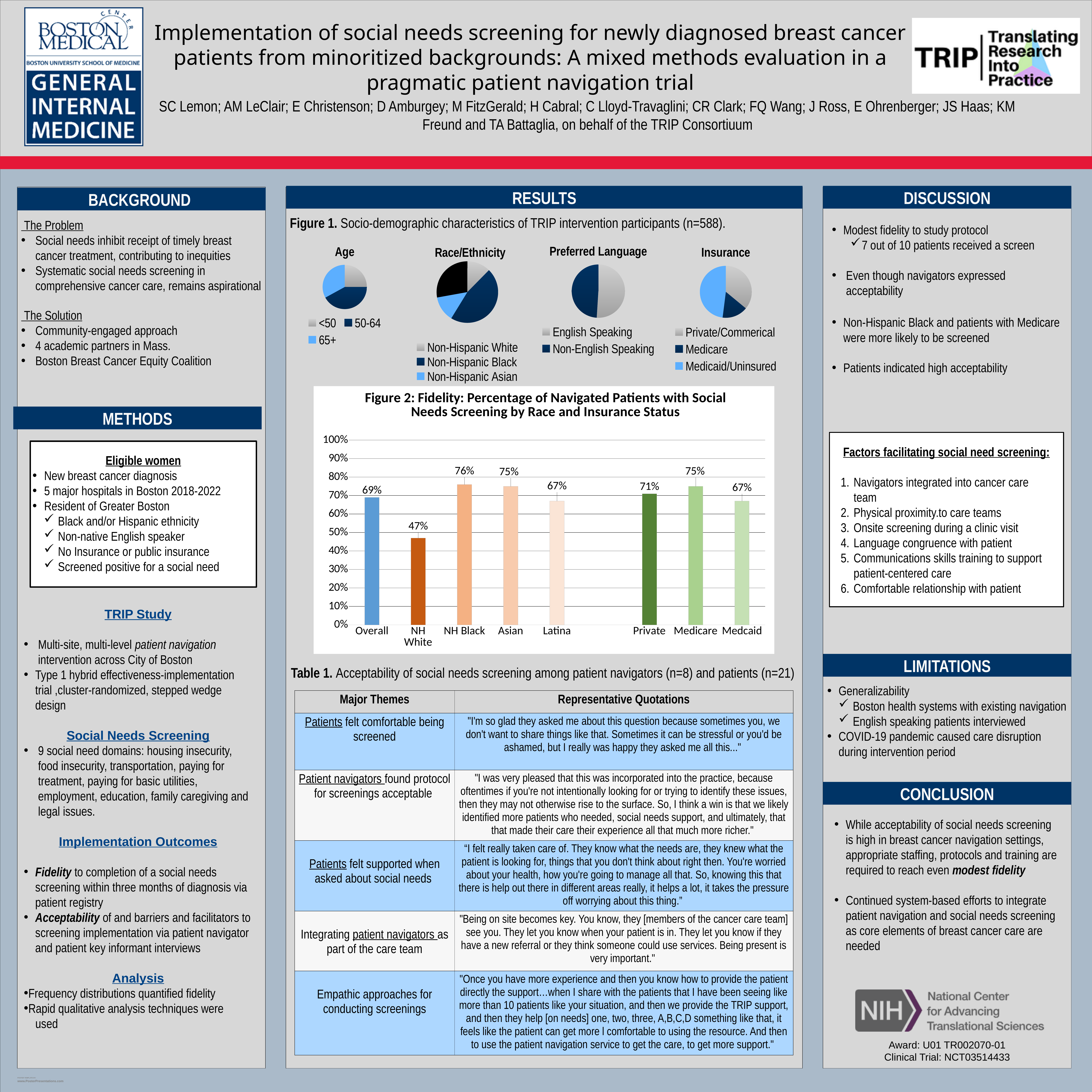
In Figure 2, how many categories (bars) are plotted? 8 In Figure 2, which category has the highest screening percentage? NH Black In Figure 1, how many categories does the legend of the Preferred Language pie chart list? 2 In Figure 2, what is the screening percentage for NH White patients? 47% In Figure 2, which has a higher screening percentage, Medicare or Medcaid? Medicare What kind of chart is Figure 2? Bar chart What kind of charts are used in Figure 1 to show the socio-demographic characteristics? Pie charts In Figure 2, which category has the lowest screening percentage? NH White In Figure 2, what is the screening percentage for Latina patients? 67% In Figure 2, what is the screening percentage for patients with Medicare? 75% In Figure 2, what is the difference in percentage points between NH Black and NH White patients? 29 percentage points In Figure 2, what percentage of navigated patients overall received social needs screening? 69%